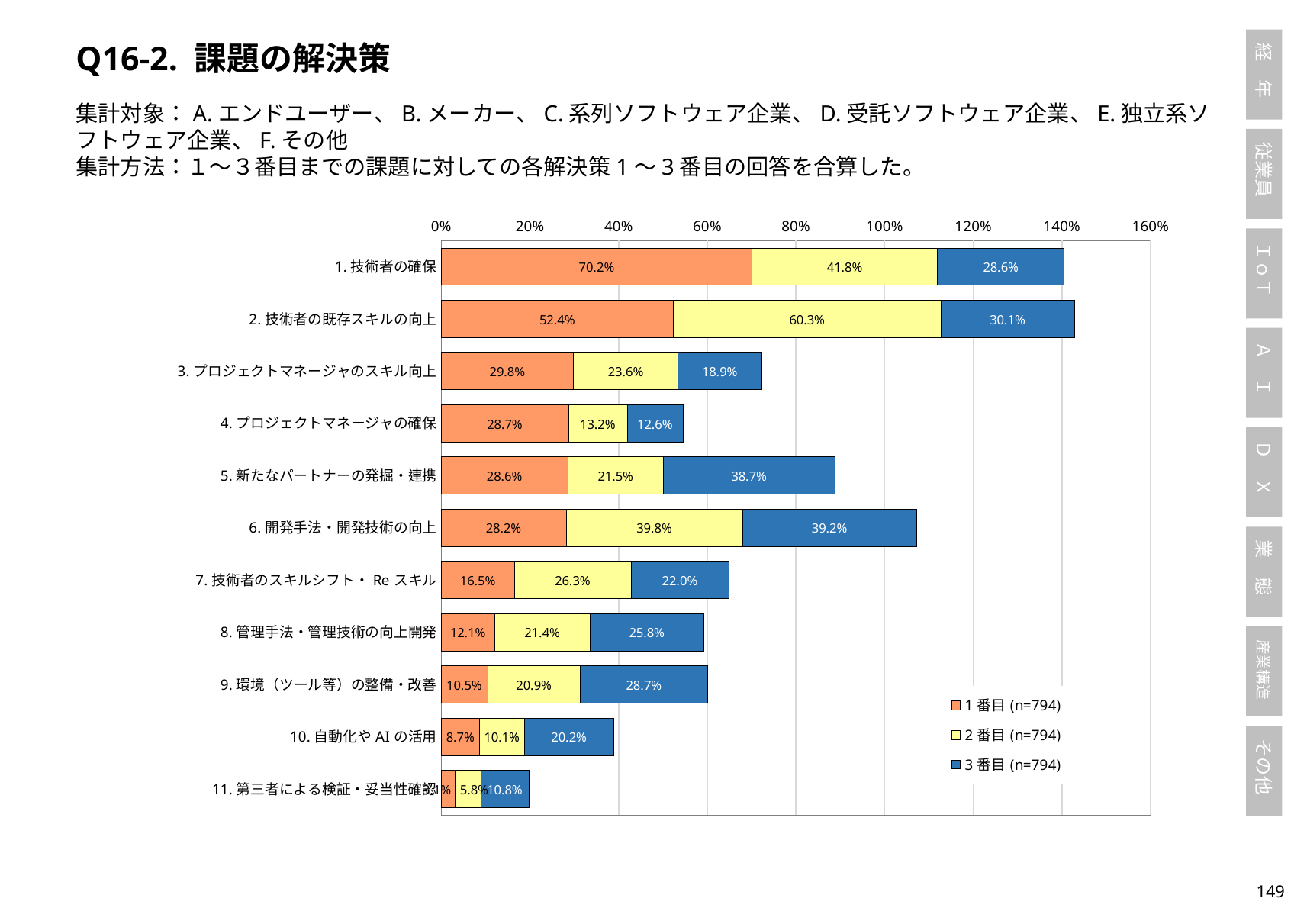
What is the total of the stacked bar for 6. 開発手法・開発技術の向上? 107.2% Which is larger: the 2番目 value for 6. 開発手法・開発技術の向上 or for 7. 技術者のスキルシフト・Re スキル? 6. 開発手法・開発技術の向上 What is the 2番目 value for 2. 技術者の既存スキルの向上? 60.3% What is the 3番目 value for 5. 新たなパートナーの発掘・連携? 38.7% What type of chart is shown on the slide? Stacked bar chart Which category has the lowest 3番目 value? 11. 第三者による検証・妥当性確認 What is the difference between the 1番目 values for 1. 技術者の確保 and 2. 技術者の既存スキルの向上? 17.8% Which category has the highest 1番目 value? 1. 技術者の確保 Is the total stacked bar for 3. プロジェクトマネージャのスキル向上 greater or less than 80%? less How many categories (solution items) are plotted on the chart? 11 What is the 1番目 value for 1. 技術者の確保? 70.2% How many series does the legend list? 3